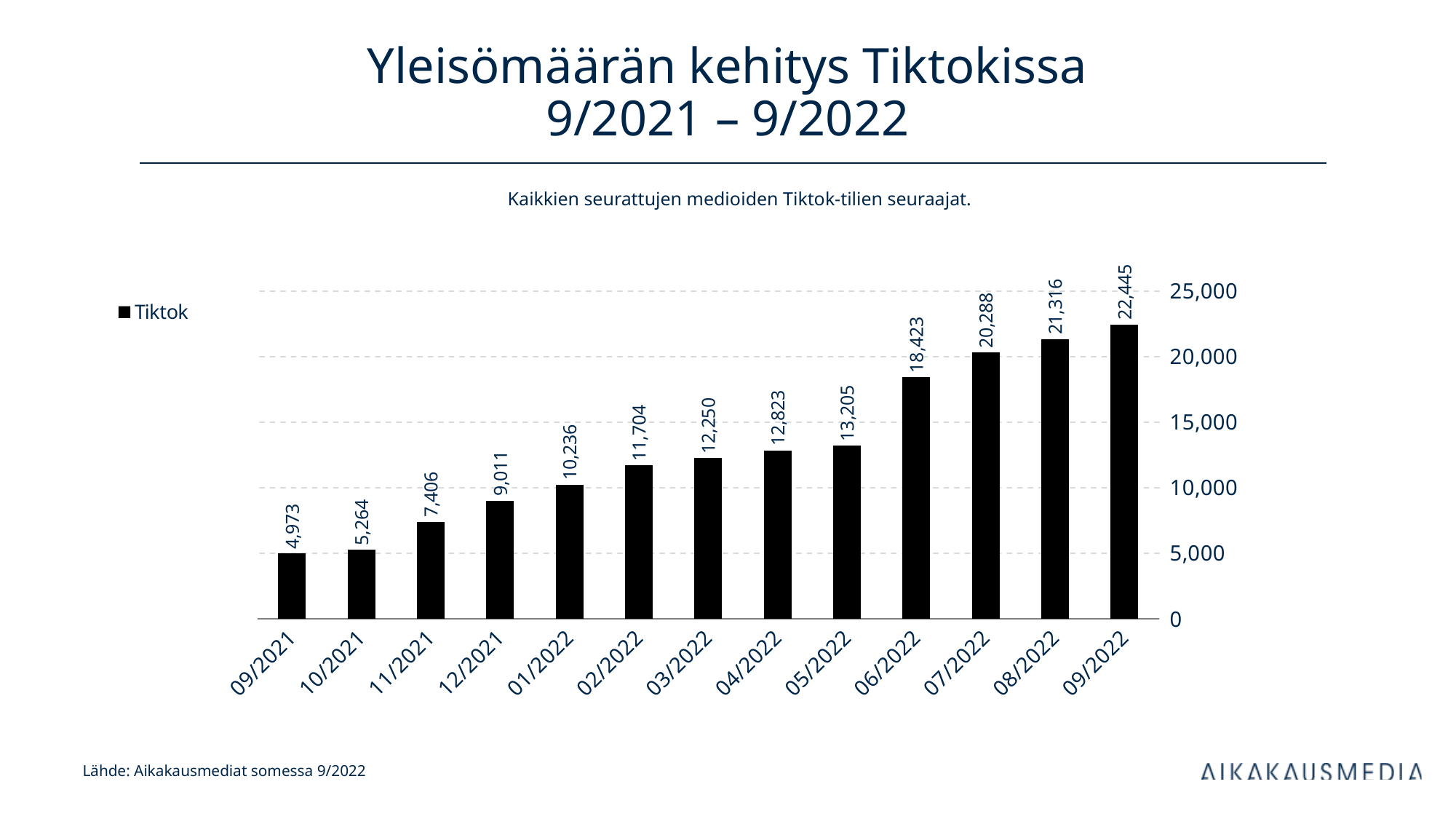
Do the values rise or fall from 09/2021 to 09/2022? rise What is the value for 03/2022? 12,250 What kind of chart is shown on the slide? bar chart Which month has the highest value? 09/2022 Which is larger, the value for 12/2021 or the value for 01/2022? 01/2022 What is the value for 09/2021? 4,973 Is the value for 08/2022 greater or less than 20,000? greater What is the difference between the values for 09/2022 and 09/2021? 17,472 Which month has the lowest value? 09/2021 How many months are shown on the x axis? 13 What is the value for 07/2022? 20,288 What is the difference between the values for 06/2022 and 05/2022? 5,218